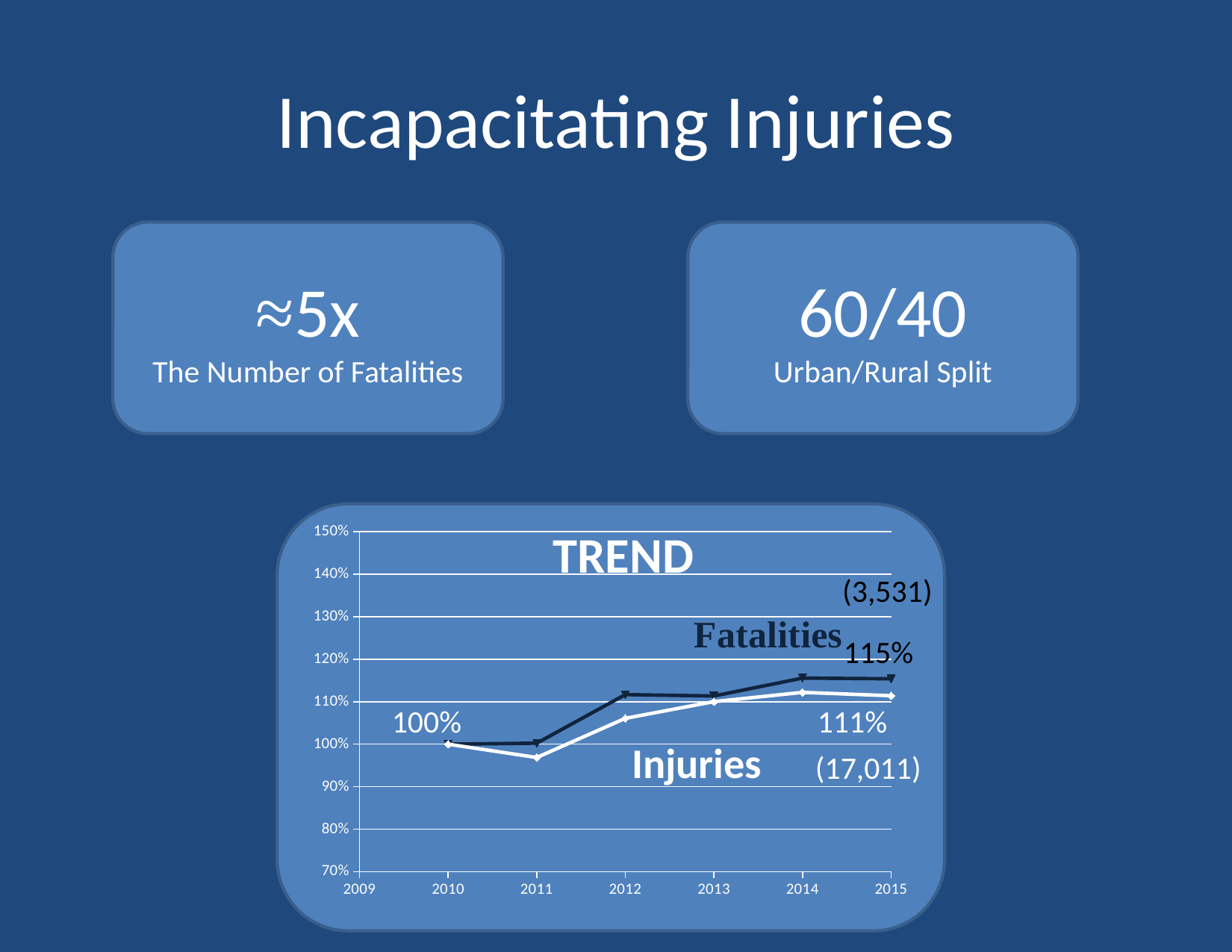
Is the Injuries value in 2011 greater or less than 100%? less Do the Fatalities values rise or fall from 2010 to 2015? rise What is the Fatalities value in 2015? 115% What is the Injuries value in 2015? 111% What is the value of both series in 2010? 100% What is the difference between the Fatalities and Injuries values in 2015? 4 percentage points In 2015, which series has the higher value, Fatalities or Injuries? Fatalities Is the Fatalities value in 2014 greater or less than 110%? greater How many series are plotted in the chart? 2 What is the title of the chart? TREND In which year is the Injuries series at its lowest? 2011 What kind of chart is shown on the slide? line chart